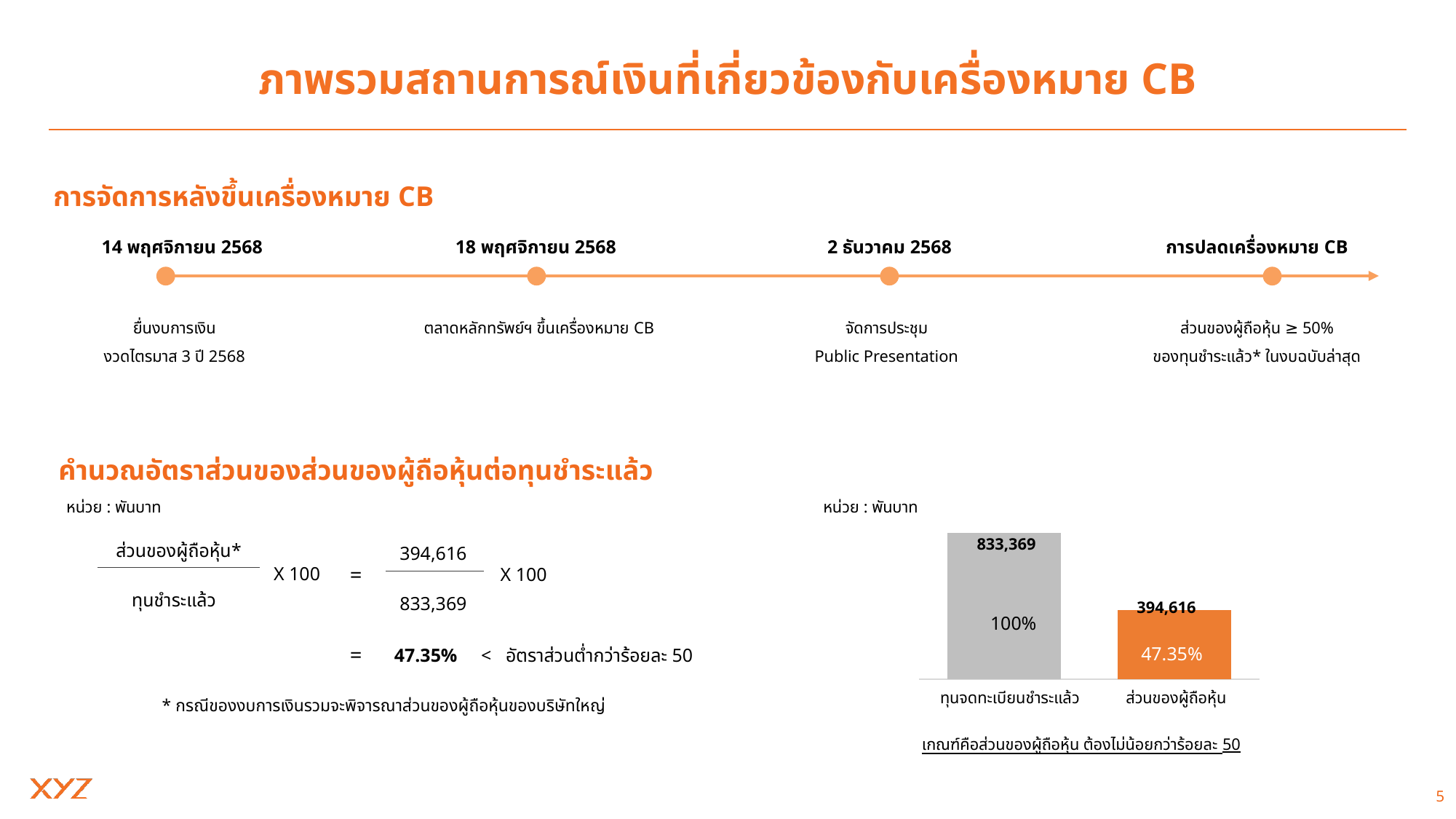
What is the value for ส่วนของผู้ถือหุ้น in the bar chart? 394,616 What type of chart is shown on the slide? bar chart What is the value for ทุนจดทะเบียนชำระแล้ว in the bar chart? 833,369 What unit is stated above the bar chart? พันบาท What percentage is shown inside the ทุนจดทะเบียนชำระแล้ว bar? 100% What percentage is shown inside the ส่วนของผู้ถือหุ้น bar? 47.35% What is the difference between the values for ทุนจดทะเบียนชำระแล้ว and ส่วนของผู้ถือหุ้น in the bar chart? 438,753 Which is larger in the bar chart, ทุนจดทะเบียนชำระแล้ว or ส่วนของผู้ถือหุ้น? ทุนจดทะเบียนชำระแล้ว Which category has the lowest value in the bar chart? ส่วนของผู้ถือหุ้น How many bars are shown in the bar chart? 2 Which category has the highest value in the bar chart? ทุนจดทะเบียนชำระแล้ว What colour is the ส่วนของผู้ถือหุ้น bar in the chart? orange